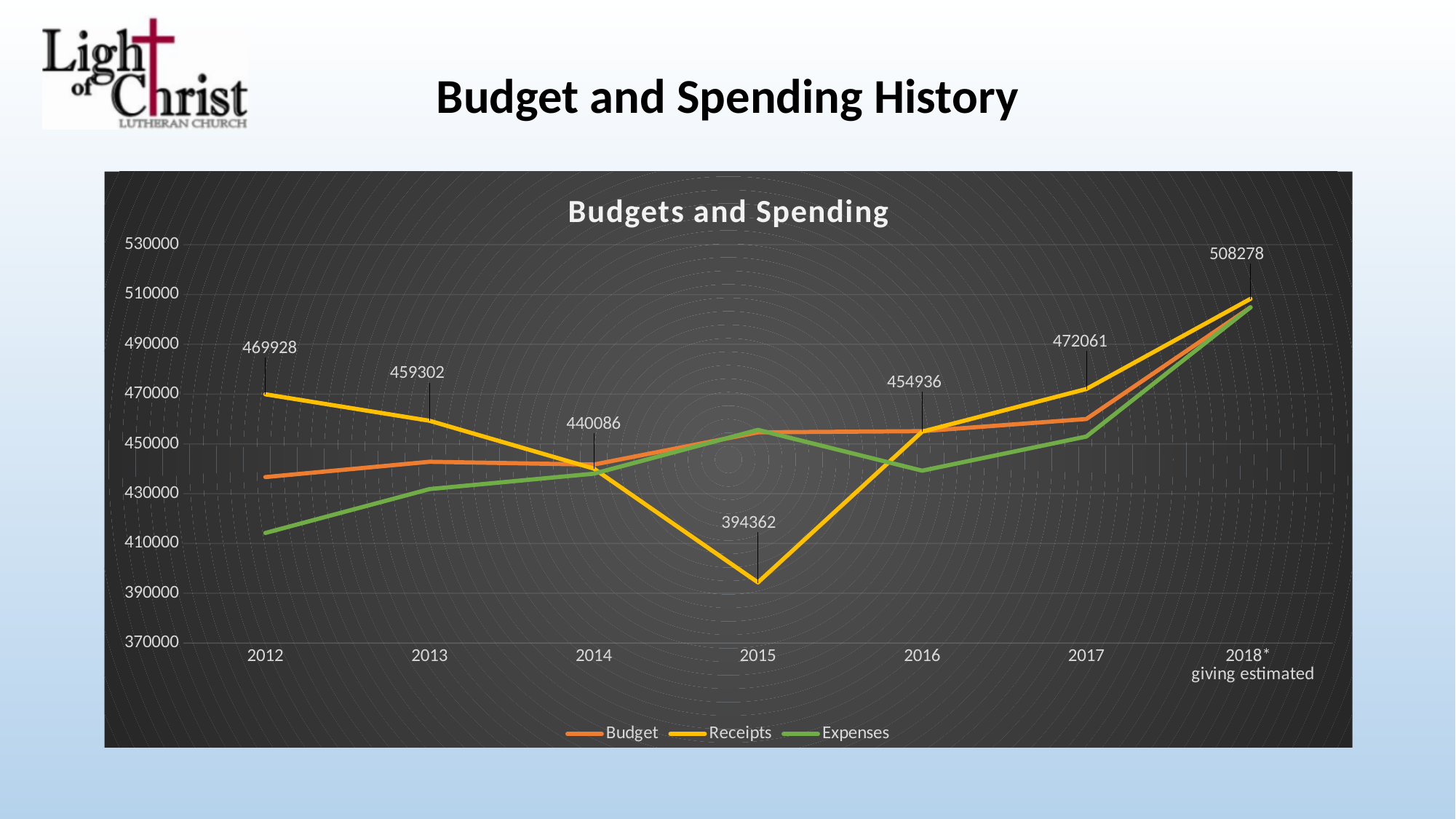
In which year are Receipts highest? 2018* What is the Receipts value for 2012? 469928 What is the Receipts value for 2018*? 508278 Is the Expenses value for 2012 greater or less than 430000? less How many series does the legend list in the Budgets and Spending chart? 3 What is the Receipts value for 2015? 394362 Which is larger in 2012, Receipts or Expenses? Receipts In which year are Receipts lowest? 2015 What type of chart is shown on the slide? Line chart How many years are plotted along the x axis of the Budgets and Spending chart? 7 Do Receipts rise or fall from 2015 to 2018*? Rise What is the difference between Receipts in 2018* and Receipts in 2017? 36217